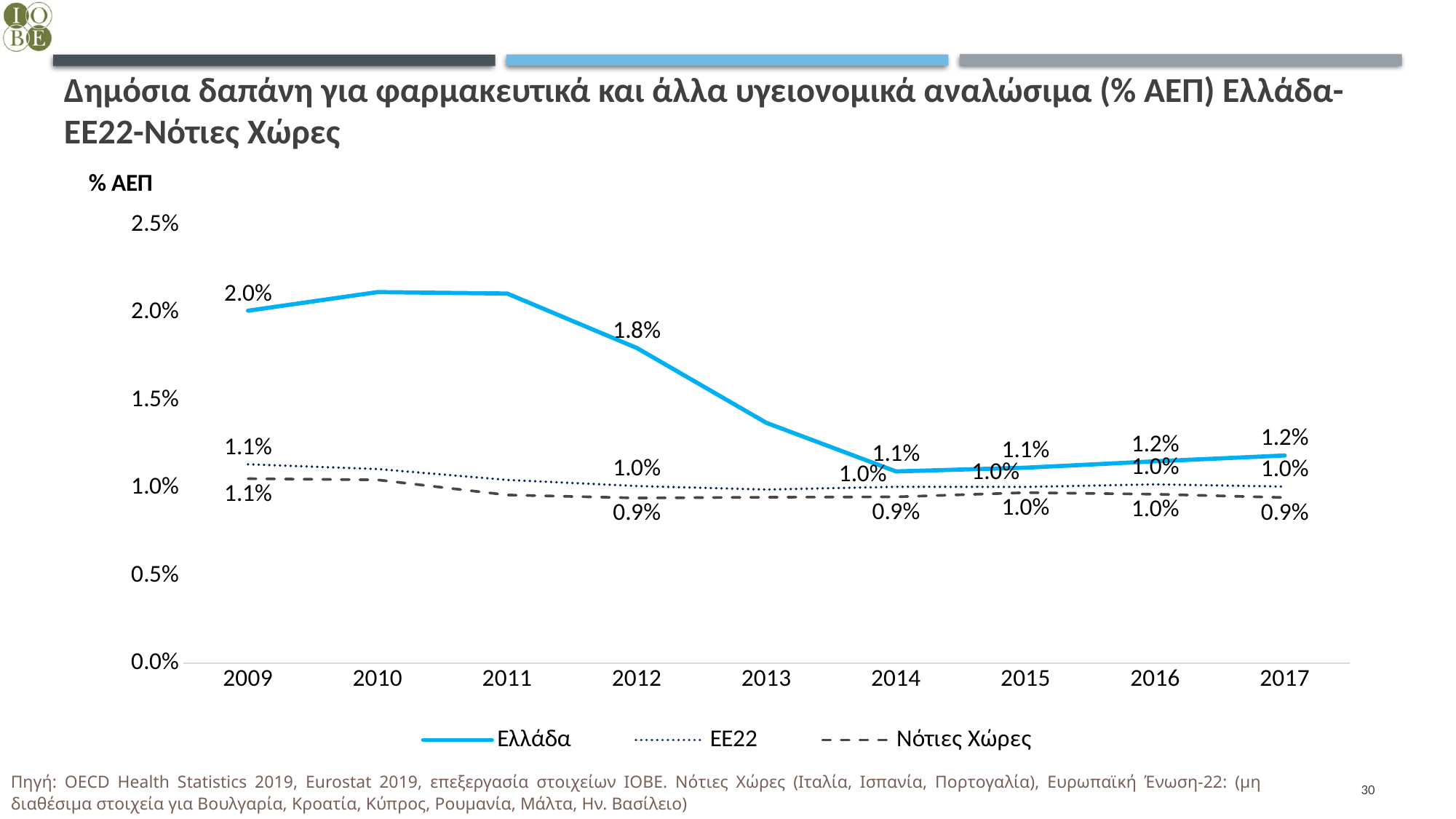
How many series does the legend list? 3 What is the value for Ελλάδα in 2009? 2.0% In 2017, which is larger: the value for Ελλάδα or the value for Νότιες Χώρες? Ελλάδα How many years are shown on the x axis? 9 What is the value for ΕΕ22 in 2017? 1.0% What is the value for Ελλάδα in 2012? 1.8% Which series has the highest value in 2009? Ελλάδα Does the value for Ελλάδα rise or fall between 2011 and 2014? fall Is the value for Ελλάδα in 2013 greater or less than 1.5%? less What is the value for Νότιες Χώρες in 2017? 0.9% What is the difference between the Ελλάδα and ΕΕ22 values in 2009? 0.9 percentage points What kind of chart is shown on the slide? line chart